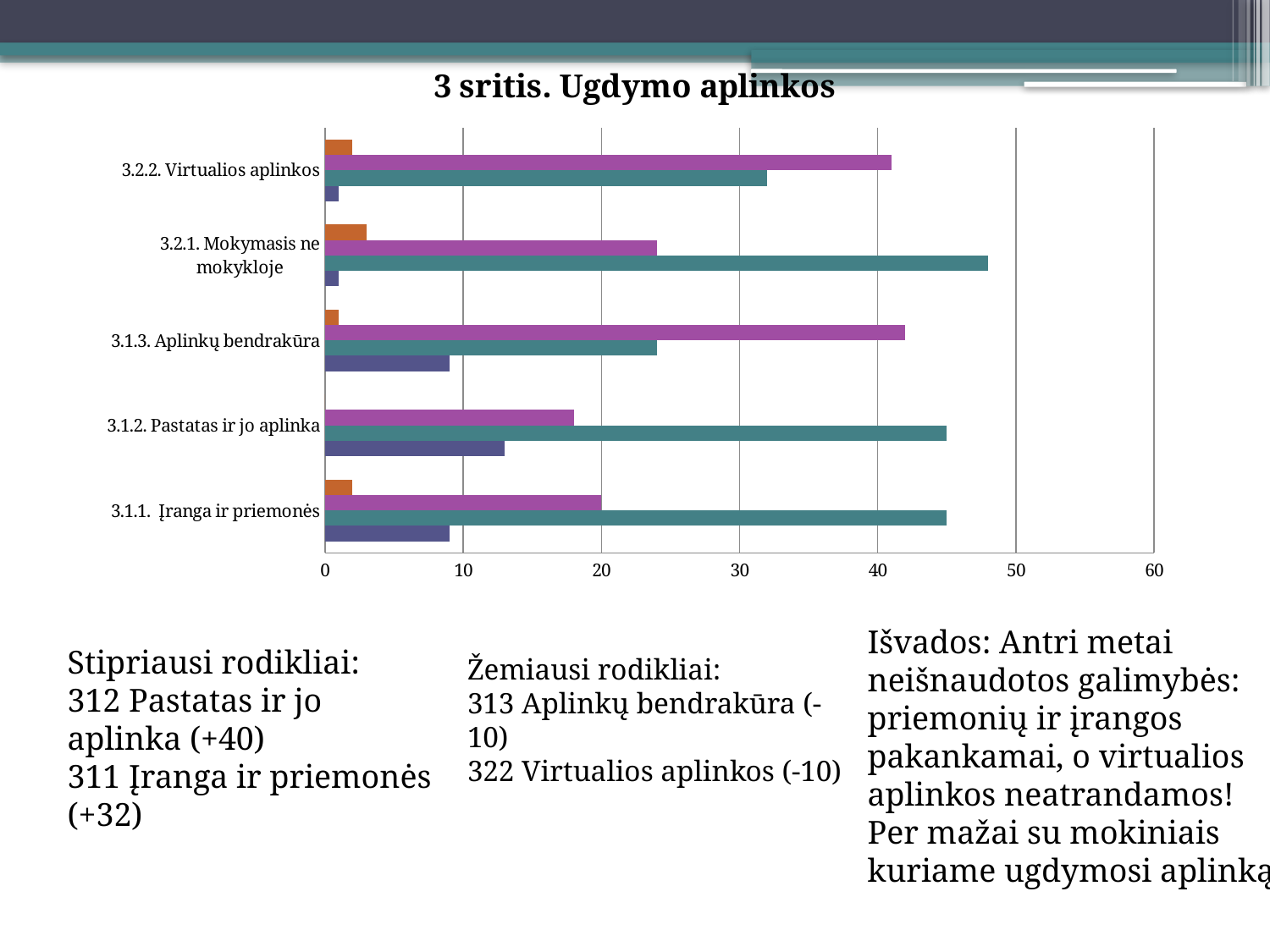
For 3.2.2. Virtualios aplinkos, which bar is longer: the purple one or the teal one? the purple one Which category has the longest dark blue bar? 3.1.2. Pastatas ir jo aplinka What is the title of the chart? 3 sritis. Ugdymo aplinkos Is the purple bar for 3.1.2. Pastatas ir jo aplinka greater or less than 30? less Is the teal bar for 3.1.3. Aplinkų bendrakūra greater or less than 30? less How many categories are shown on the chart's vertical axis? 5 Is the purple bar for 3.2.2. Virtualios aplinkos greater or less than 30? greater For 3.2.1. Mokymasis ne mokykloje, which bar is longer: the teal one or the purple one? the teal one How many differently coloured bars (series) are plotted for each category? 4 What kind of chart is shown on the slide? bar chart